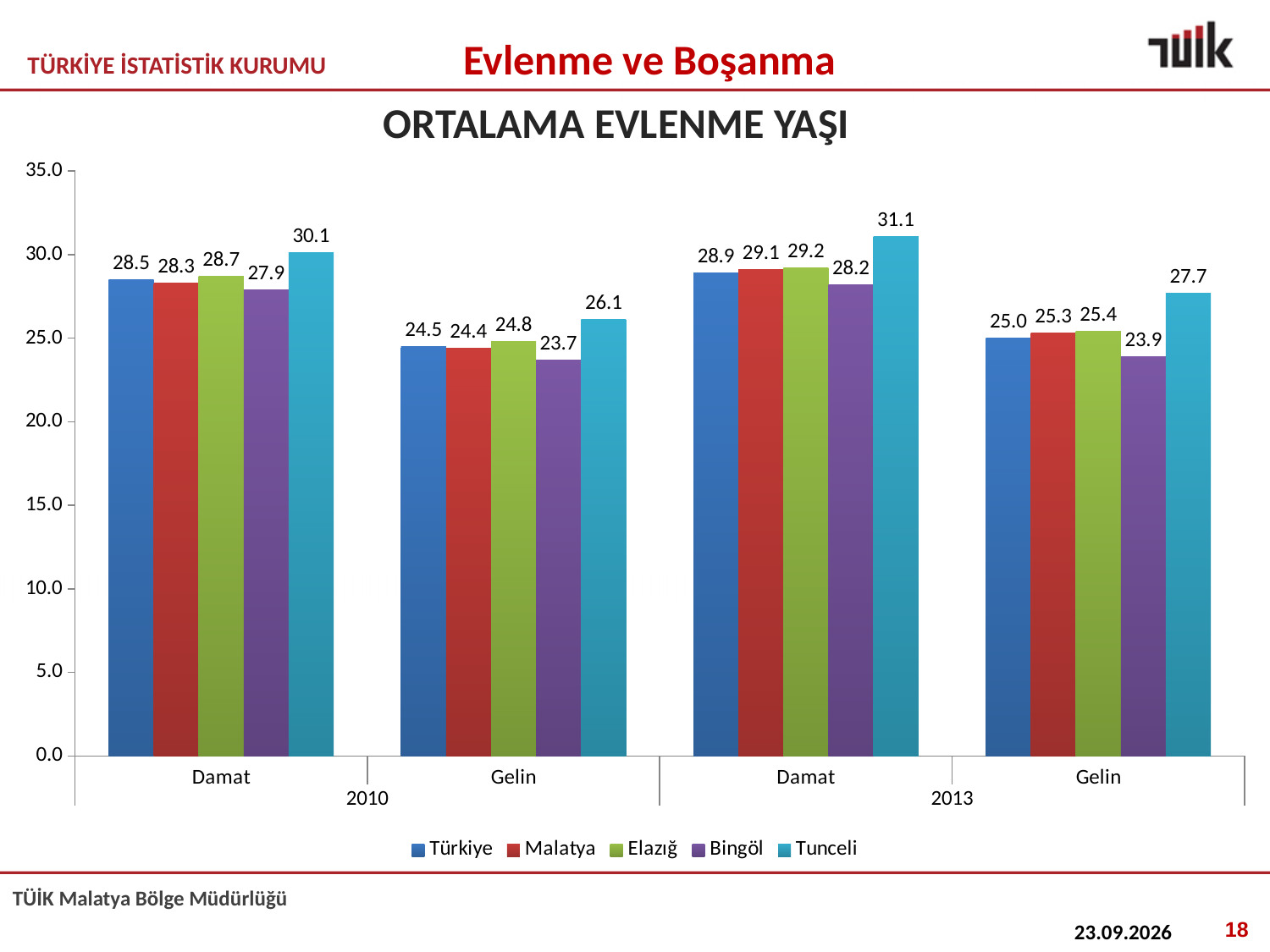
What is the difference between the Tunceli and Türkiye values in the Gelin 2013 group? 2.7 How many series does the legend list? 5 What is the value for Türkiye in the Gelin 2013 group? 25.0 What is the difference between the Elazığ values for Damat in 2013 and Damat in 2010? 0.5 Which series has the highest value in the Damat 2010 group? Tunceli What is the title of the chart? ORTALAMA EVLENME YAŞI Is the value for Tunceli in the Gelin 2010 group greater or less than 25.0? greater Which is larger: the Malatya value for Damat 2010 or the Malatya value for Damat 2013? Damat 2013 What kind of chart is shown on the slide? Bar chart Which series has the lowest value in the Gelin 2013 group? Bingöl What is the average marriage age for Tunceli grooms (Damat) in 2013? 31.1 What is the value for Bingöl in the Gelin 2010 group? 23.7